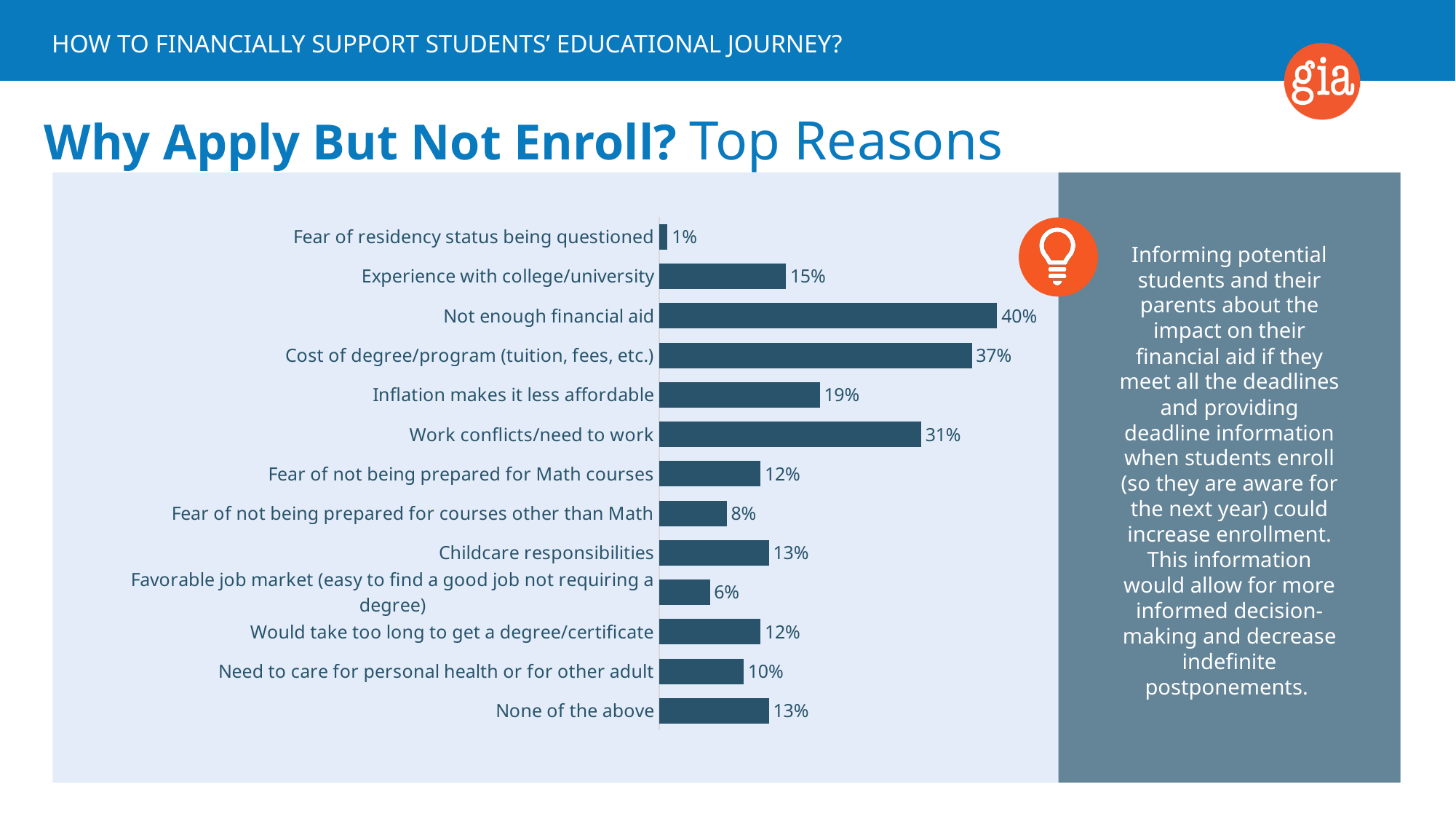
What is the difference between "Work conflicts/need to work" and "Inflation makes it less affordable"? 12% How many reasons (categories) are plotted in the chart? 13 What is the difference between "Not enough financial aid" and "Cost of degree/program (tuition, fees, etc.)"? 3% What percentage is shown for "Favorable job market (easy to find a good job not requiring a degree)"? 6% What percentage is shown for "Not enough financial aid"? 40% What percentage is shown for "Work conflicts/need to work"? 31% What kind of chart is shown on the slide? Bar chart Which reason has the highest percentage? Not enough financial aid Which reason has the lowest percentage? Fear of residency status being questioned What percentage is shown for "Inflation makes it less affordable"? 19% What is the title of the slide containing the chart? Why Apply But Not Enroll? Top Reasons Which is larger: "Experience with college/university" or "Childcare responsibilities"? Experience with college/university